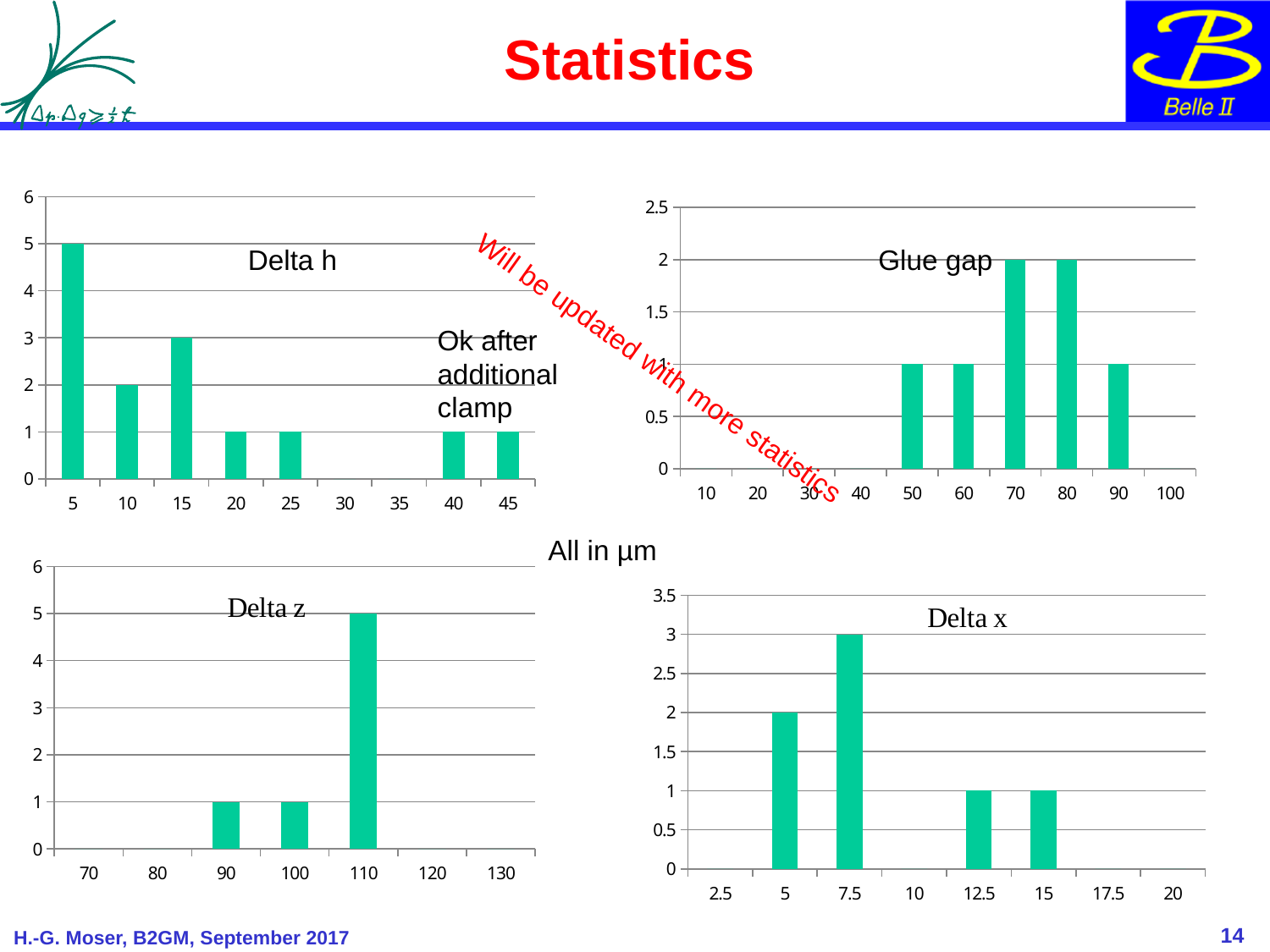
In the Delta h chart, which category has the highest value? 5 In the Glue gap chart, what is the value for category 70? 2 In the Delta x chart, what is the difference between the values for categories 7.5 and 12.5? 2 In the Delta z chart, which category has the highest value? 110 How many categories are shown on the x axis of the Glue gap chart? 10 In the Glue gap chart, which is larger, the value for 60 or the value for 80? 80 In the Delta h chart, what is the value for category 5? 5 In the Delta z chart, what is the value for category 90? 1 In the Delta h chart, what is the value for category 15? 3 What kind of chart is the Delta x chart? Bar chart In the Delta x chart, what is the value for category 7.5? 3 In the Delta h chart, what is the difference between the values for categories 5 and 10? 3